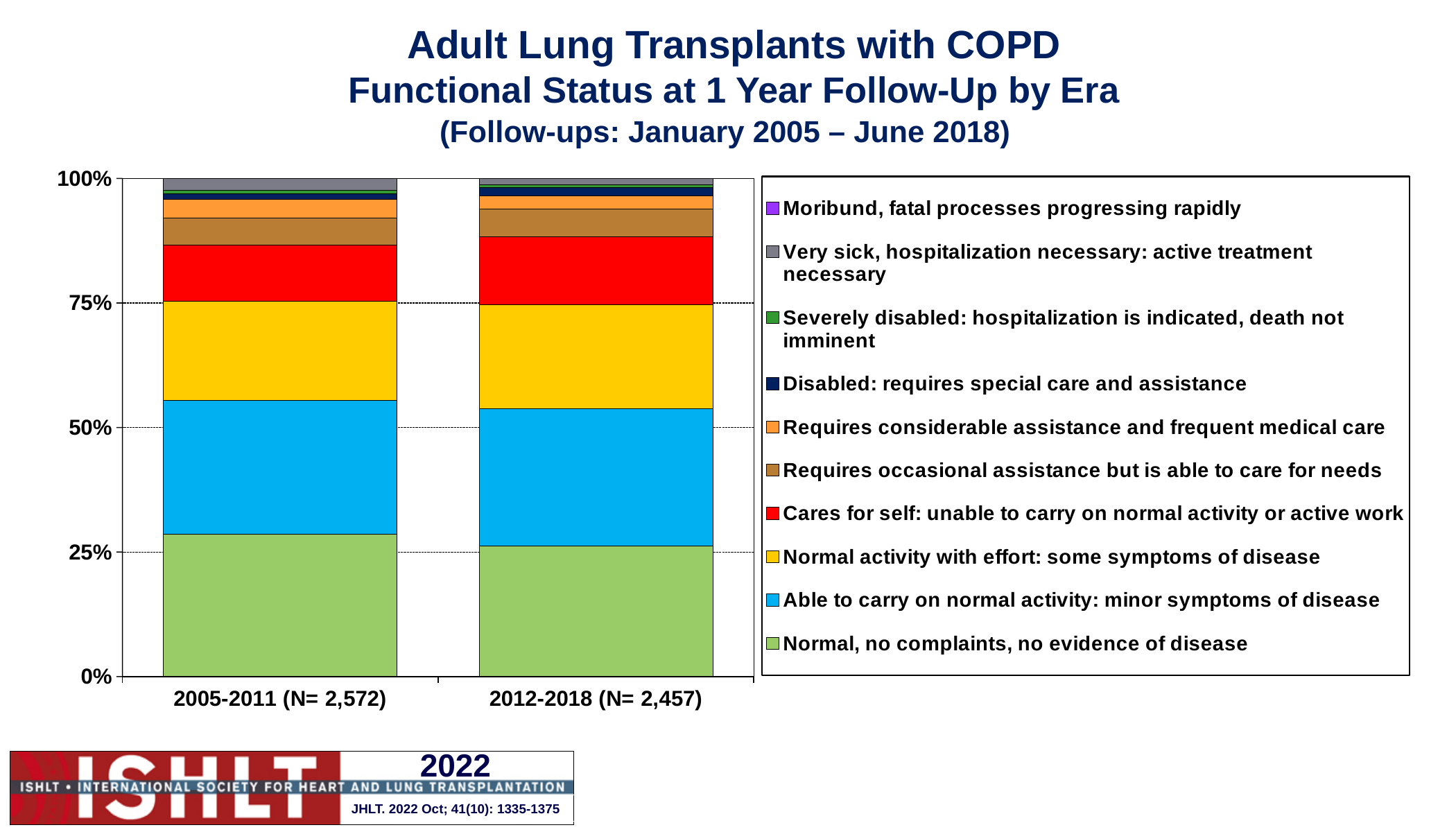
Is the cumulative share up to the top of the red 'Cares for self' segment in the 2012-2018 bar greater or less than 75%? greater What is the N shown for the 2005-2011 era? 2,572 Is the share of 'Normal, no complaints, no evidence of disease' in the 2005-2011 era greater or less than 25%? greater How many functional status categories does the legend list? 10 Is the combined share of the bottom two segments (Normal, no complaints plus Able to carry on normal activity) in the 2005-2011 bar greater or less than 50%? greater Which era has the larger share of 'Very sick, hospitalization necessary: active treatment necessary': 2005-2011 or 2012-2018? 2005-2011 What kind of chart is shown on the slide? Stacked bar chart Which era has the larger share of 'Normal, no complaints, no evidence of disease': 2005-2011 or 2012-2018? 2005-2011 What is the N shown for the 2012-2018 era? 2,457 How many era categories (bars) are plotted on the x axis? 2